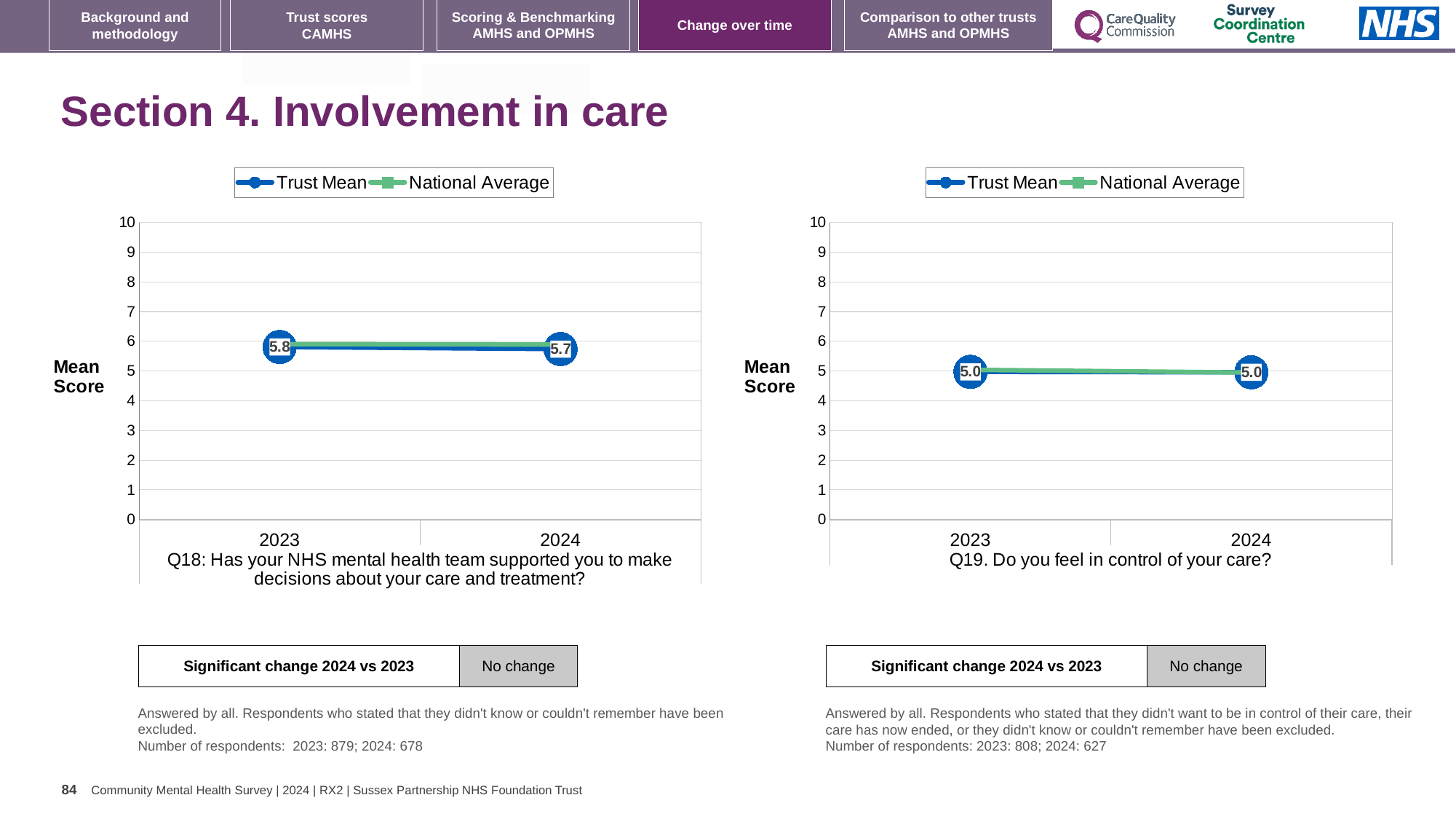
In the Q19 chart, what is the Trust Mean score for 2024? 5.0 What kind of chart is the Q19 chart? line chart In the Q19 chart, is the National Average value for 2023 greater or less than 7? less In the Q18 chart, what is the difference between the Trust Mean scores for 2023 and 2024? 0.1 In the Q18 chart, is the National Average value for 2024 greater or less than 5? greater In the Q18 chart, what is the Trust Mean score for 2023? 5.8 What is the label on the y axis of the Q18 chart? Mean Score How many years are plotted on the x axis of the Q19 chart? 2 In the Q18 chart, what is the Trust Mean score for 2024? 5.7 In the Q19 chart, does the Trust Mean rise, fall or stay the same from 2023 to 2024? stay the same How many series does the legend of the Q18 chart list? 2 In the Q18 chart, does the Trust Mean rise or fall from 2023 to 2024? fall